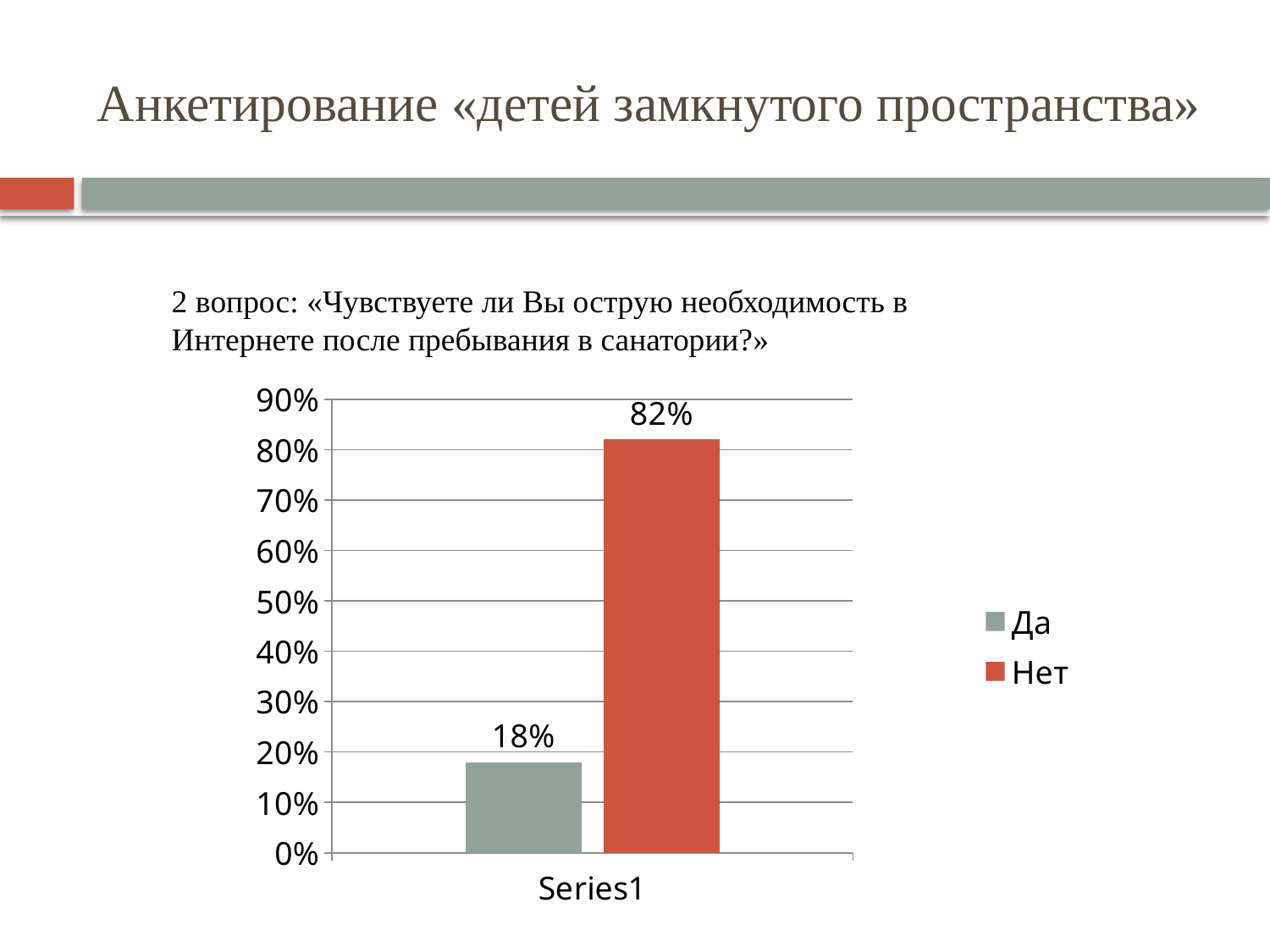
Which is larger, the value for "Да" or the value for "Нет"? Нет What colour is the bar for "Нет"? red What is the difference between the values for "Нет" and "Да"? 64% Which series has the highest value? Нет What is the value for "Да"? 18% What is the value for "Нет"? 82% Is the value for "Нет" greater or less than 50%? greater What kind of chart is shown on the slide? bar chart How many series does the legend list? 2 What is the category label shown on the x axis? Series1 Is the value for "Да" greater or less than 30%? less Which series has the lowest value? Да